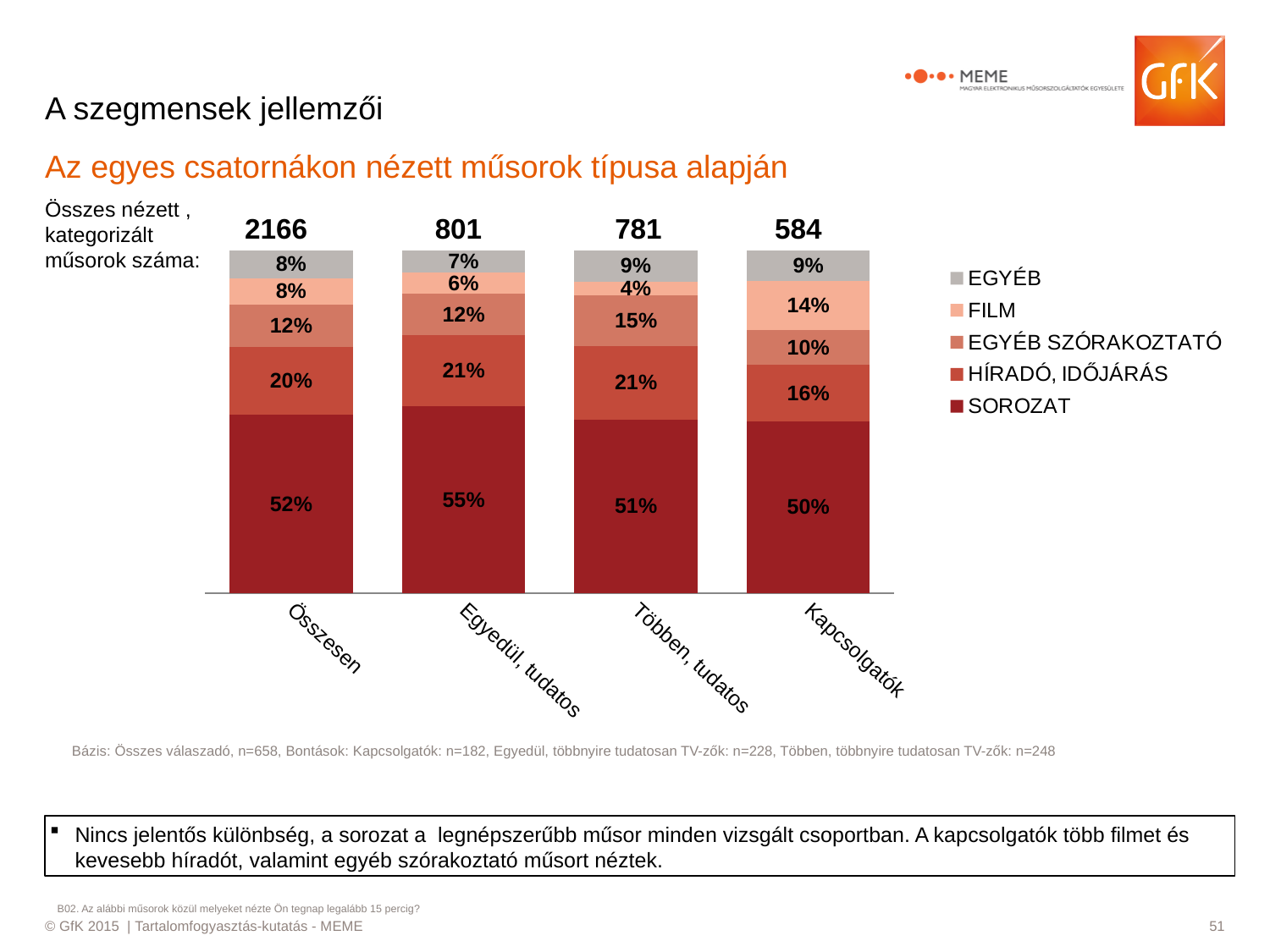
How many categories are shown along the x axis? 4 Which is larger: the EGYÉB SZÓRAKOZTATÓ share for Többen, tudatos or for Kapcsolgatók? Többen, tudatos What kind of chart is shown on the slide? stacked bar chart What is the number of categorised programmes shown above the Kapcsolgatók bar? 584 What is the total of the stacked bar for Összesen? 100% What is the difference between the HÍRADÓ, IDŐJÁRÁS share for Többen, tudatos and for Kapcsolgatók? 5% Which group has the lowest FILM share? Többen, tudatos Which group has the highest SOROZAT share? Egyedül, tudatos What is the HÍRADÓ, IDŐJÁRÁS share for the Összesen group? 20% What is the SOROZAT share for the Egyedül, tudatos group? 55% What is the FILM share for the Kapcsolgatók group? 14% How many series does the legend list? 5